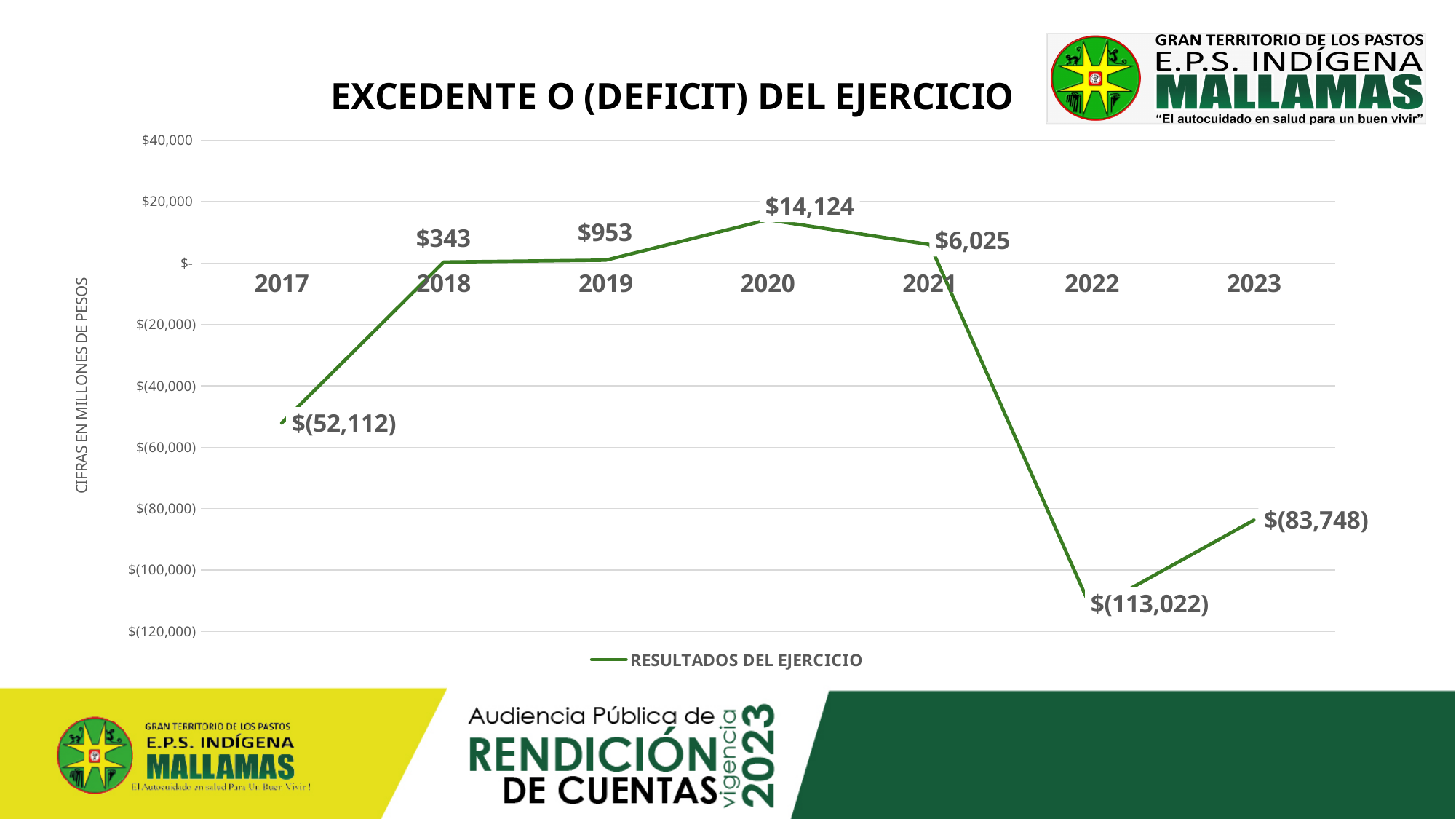
What is the value for 2022? $(113,022) What is the value for 2020? $14,124 What kind of chart is shown? Line chart What is the series name shown in the legend? RESULTADOS DEL EJERCICIO Which year has the lowest value? 2022 How many years are plotted on the chart? 7 What is the value for 2017? $(52,112) Which is larger, the value for 2018 or the value for 2019? 2019 Which year has the highest value? 2020 Does the value rise or fall from 2021 to 2022? Fall What is the value for 2023? $(83,748) What is the difference between the values for 2020 and 2021? $8,099